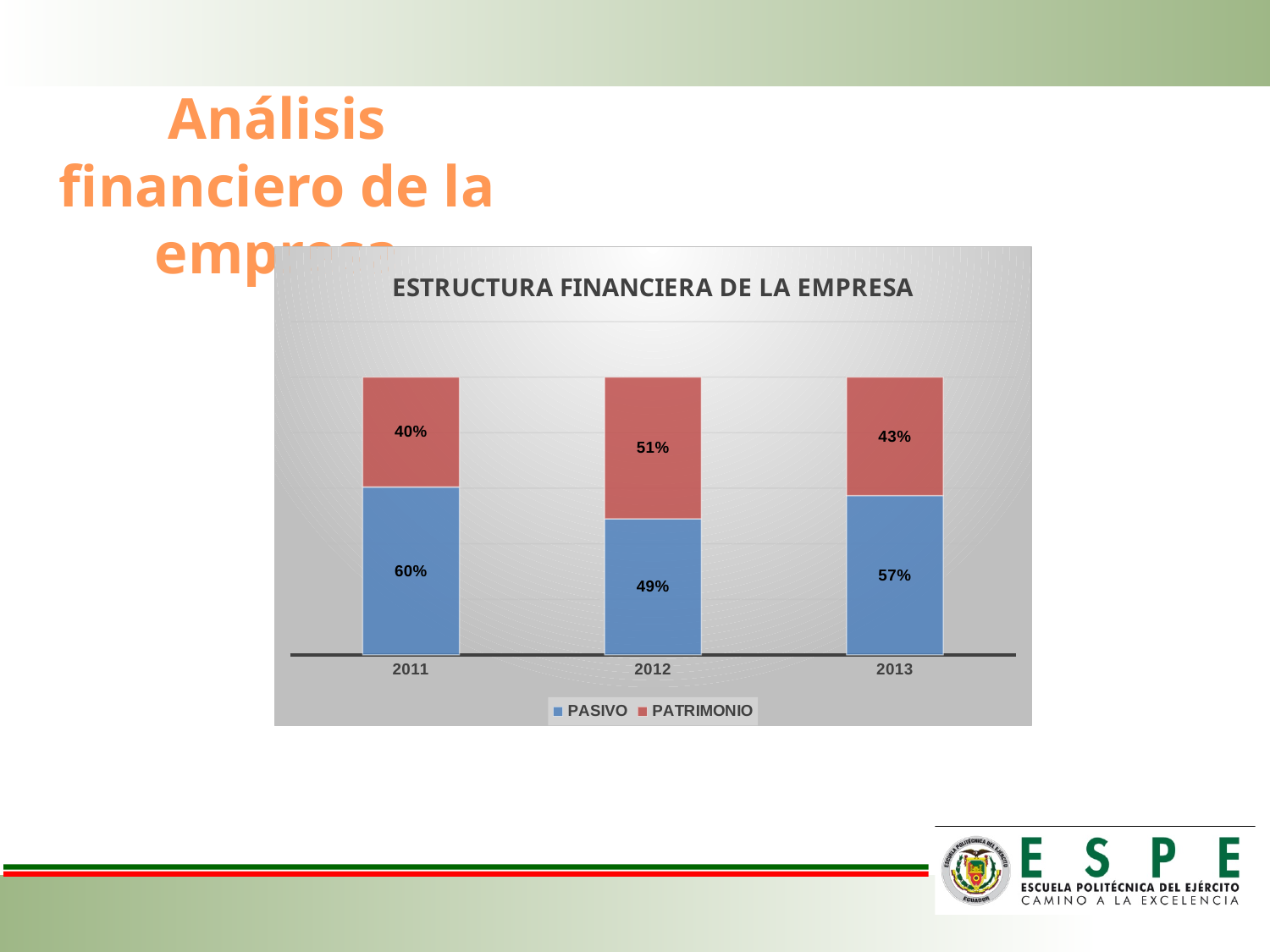
In which year is the PASIVO share highest? 2011 In which year is the PATRIMONIO share lowest? 2011 How many series does the legend list? 2 What is the PASIVO value for 2013? 57% What is the PATRIMONIO value for 2013? 43% Which is larger in 2012, PASIVO or PATRIMONIO? PATRIMONIO What is the PATRIMONIO value for 2012? 51% What is the PASIVO value for 2011? 60% What is the title of the chart? ESTRUCTURA FINANCIERA DE LA EMPRESA How many years are shown on the x axis? 3 What is the difference between the PASIVO and PATRIMONIO values in 2011? 20% What kind of chart is shown? Stacked bar chart